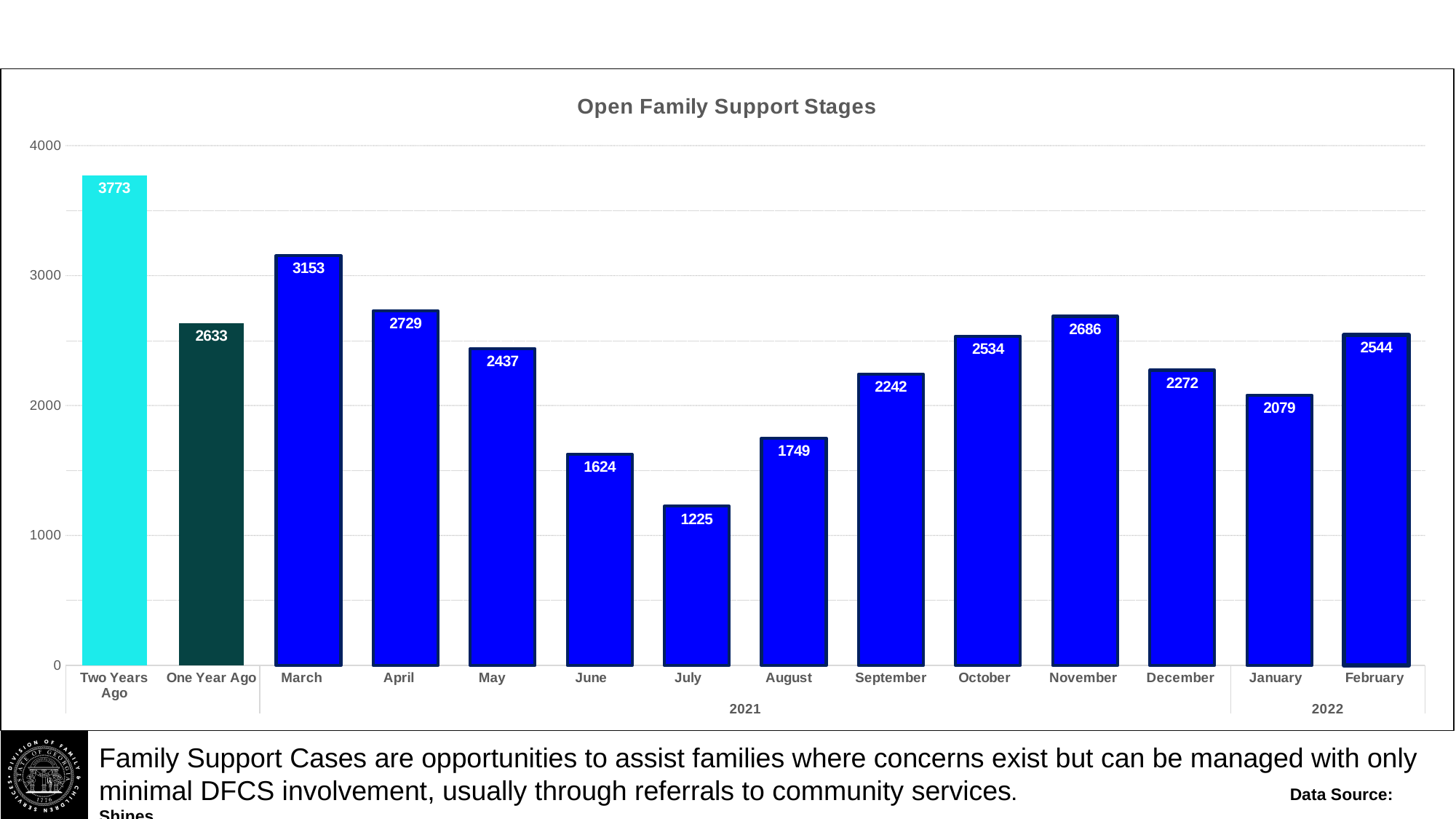
Which category has the highest value? Two Years Ago What is the title of the chart? Open Family Support Stages What kind of chart is shown? bar chart What is the value for Two Years Ago? 3773 What is the value for July 2021? 1225 Is the value for January 2022 greater or less than 3000? less What is the value for February 2022? 2544 Do the values rise or fall from March 2021 to July 2021? fall How many bars are shown in the chart? 14 What is the difference between the values for March 2021 and April 2021? 424 Which category has the lowest value? July Which is larger, the value for November 2021 or the value for October 2021? November